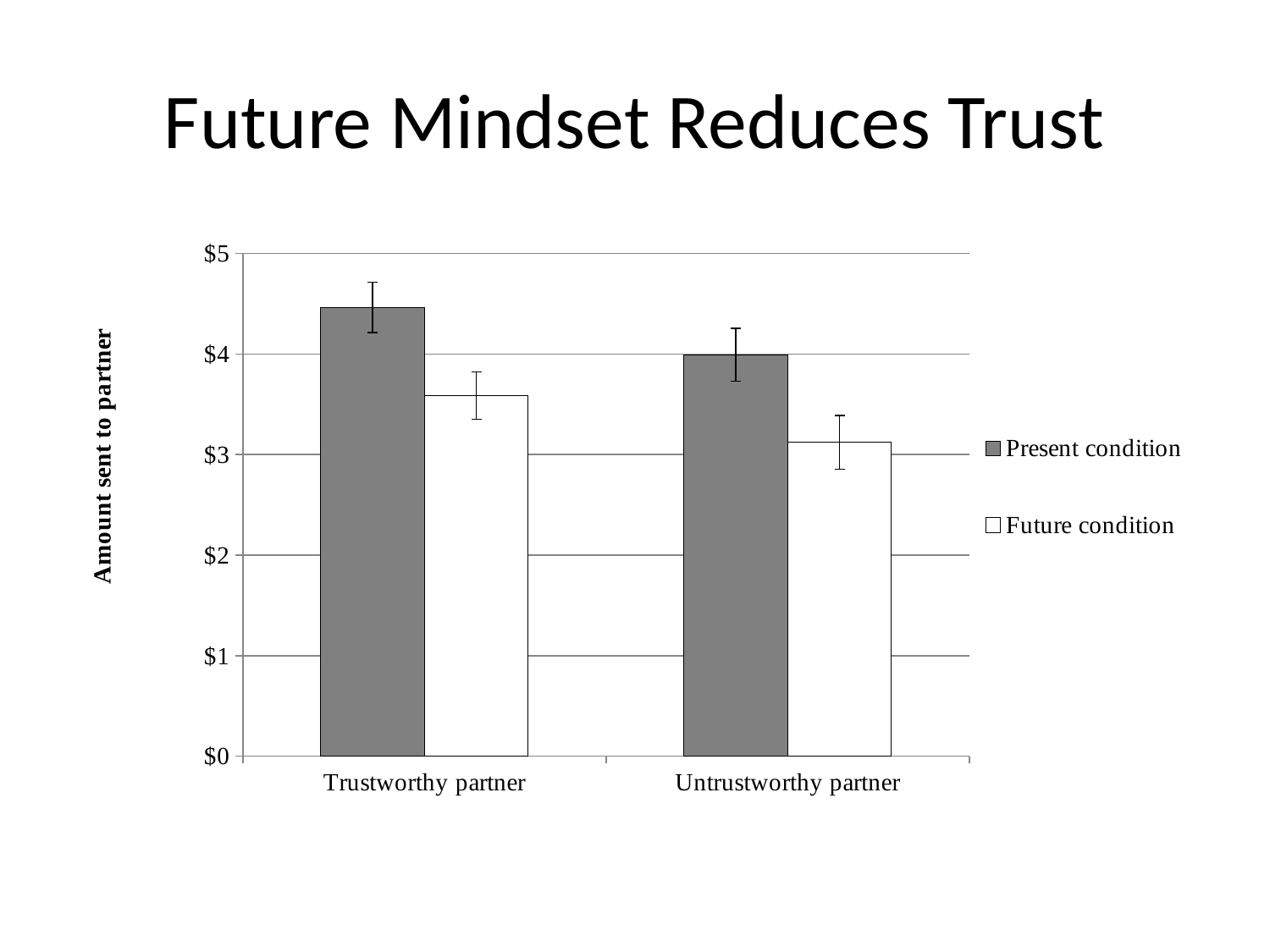
Is the value for Future condition with the Trustworthy partner greater or less than $4? less Is the value for Future condition with the Untrustworthy partner greater or less than $4? less Which bar is the highest in the chart? Present condition, Trustworthy partner For the Untrustworthy partner, which condition has the larger amount sent: Present condition or Future condition? Present condition What kind of chart is shown on the slide? bar chart For the Trustworthy partner, which condition has the larger amount sent: Present condition or Future condition? Present condition How many partner categories are shown on the x axis? 2 Is the value for Present condition with the Trustworthy partner greater or less than $4? greater What is the label on the vertical axis of the chart? Amount sent to partner Does the Present condition value rise or fall from Trustworthy partner to Untrustworthy partner? fall How many series does the legend list? 2 Which bar is the lowest in the chart? Future condition, Untrustworthy partner